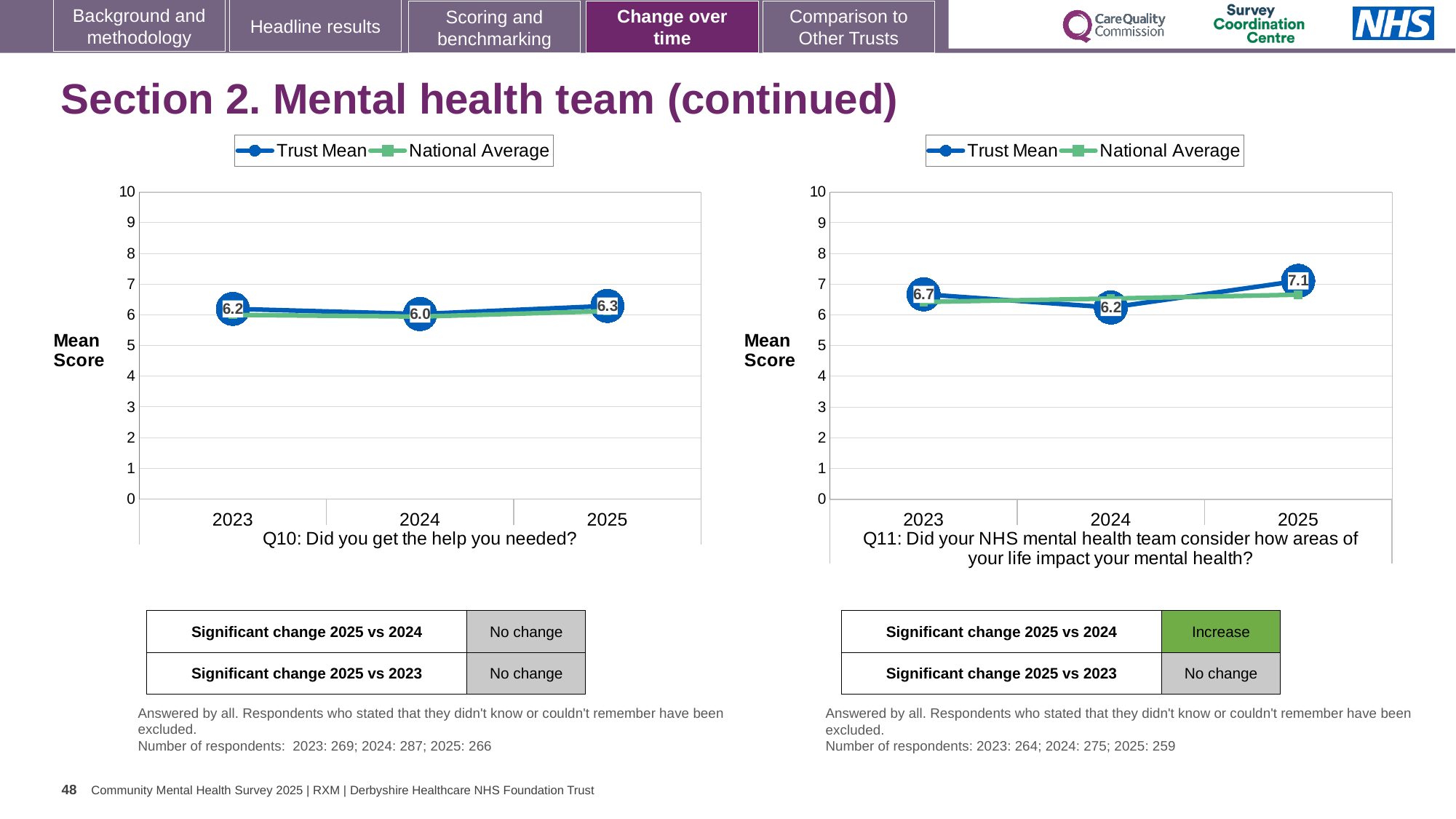
In the Q11 chart (right), is the National Average for 2025 greater or less than 5? greater How many years are shown on the x axis of the Q10 chart (left)? 3 In the Q10 chart (left), what is the Trust Mean for 2024? 6.0 What kind of chart is the Q10 chart (left)? Line chart In the Q11 chart (right), what is the Trust Mean for 2023? 6.7 In the Q10 chart (left), what is the Trust Mean for 2025? 6.3 In the Q11 chart (right), which year has the highest Trust Mean? 2025 In the Q11 chart (right), what is the difference between the Trust Mean for 2025 and the Trust Mean for 2024? 0.9 In the Q10 chart (left), which is larger, the Trust Mean for 2023 or the Trust Mean for 2024? 2023 How many series does the legend of the Q11 chart (right) list? 2 In the Q11 chart (right), what is the Trust Mean for 2025? 7.1 In the Q10 chart (left), which year has the lowest Trust Mean? 2024